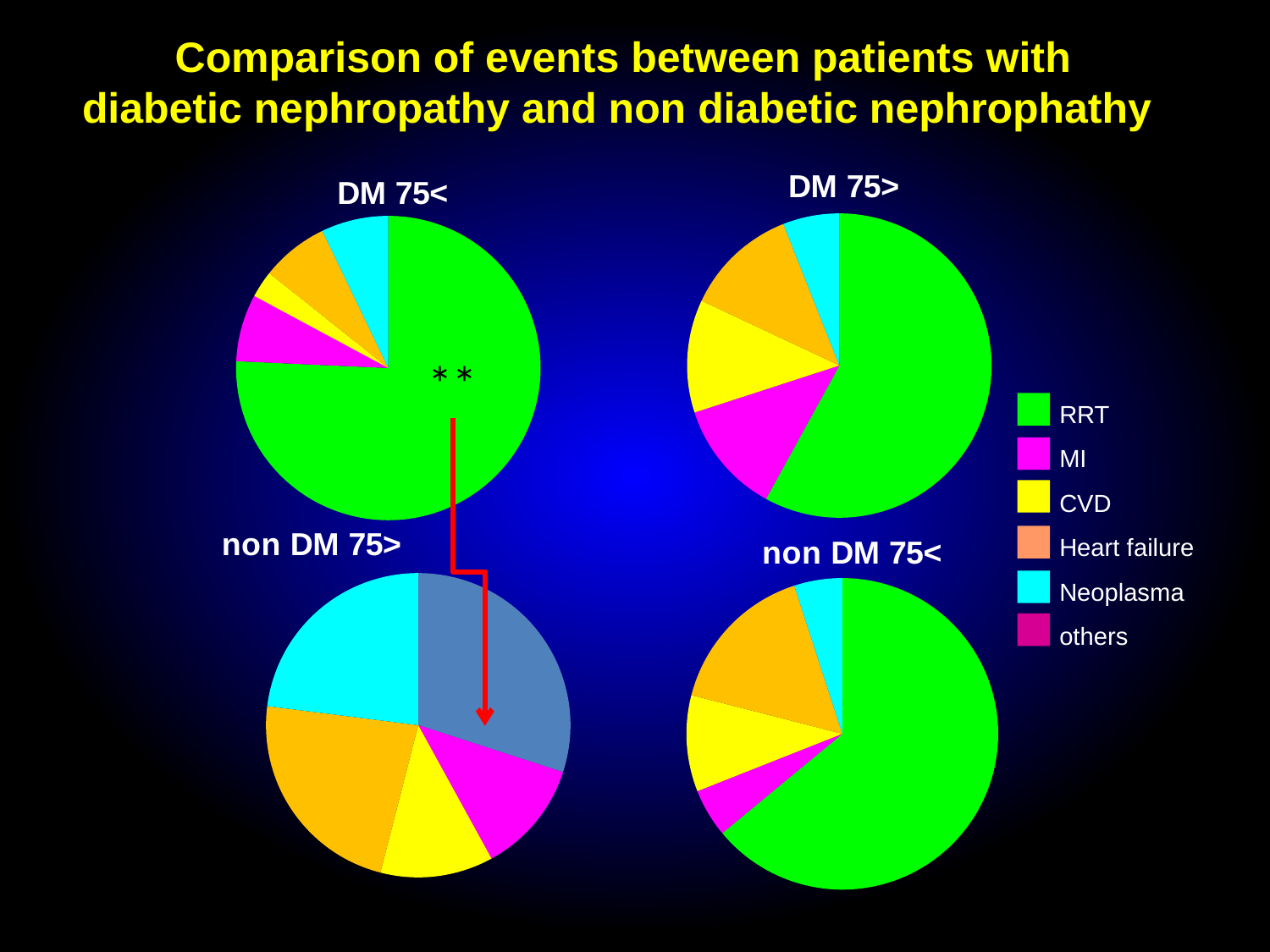
How many categories does the legend list? 6 What colour represents RRT in the legend? Green In the "DM 75>" pie chart, which slice is larger, CVD or Neoplasma? CVD How many pie charts are on the slide? 4 How many slices does the "DM 75<" pie chart have? 5 In the "non DM 75>" pie chart, which slice is larger, Heart failure or CVD? Heart failure In the "DM 75>" pie chart, which category has the smallest slice? Neoplasma In the "DM 75<" pie chart, which category has the smallest slice? CVD What kind of charts are shown on the slide? Pie charts In the "DM 75<" pie chart, which category has the largest slice? RRT In the "DM 75>" pie chart, which category has the largest slice? RRT In the "non DM 75<" pie chart, which category has the largest slice? RRT